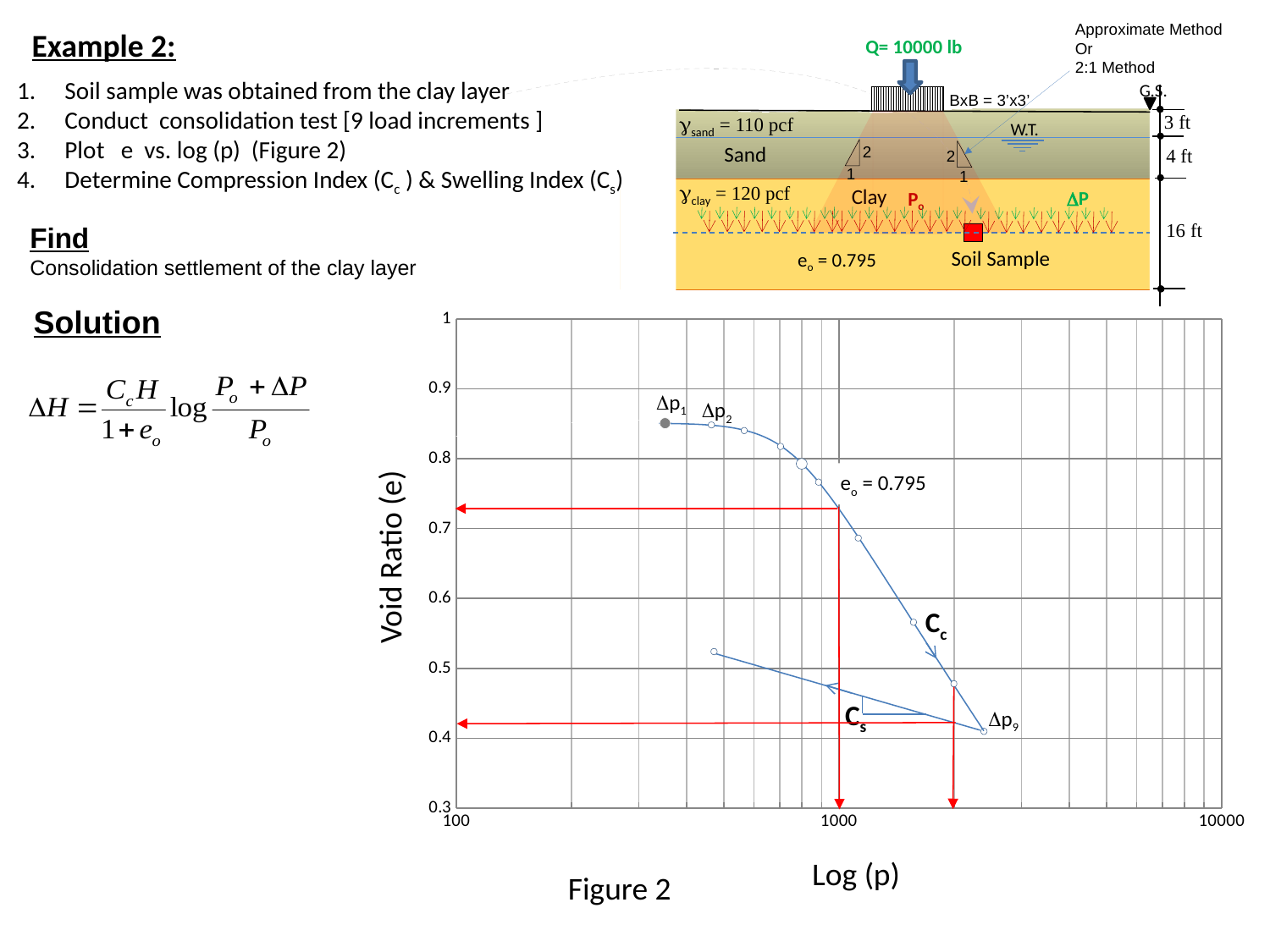
What is the label of the x-axis in Figure 2? Log (p) In Figure 2, does the void ratio rise or fall as the pressure p increases along the loading curve from Δp1 to Δp9? fall What kind of chart is Figure 2? line chart In Figure 2, what value of e_o is annotated on the chart? 0.795 What is the highest tick value shown on the y-axis of Figure 2? 1 In Figure 2, which point has the higher void ratio, Δp1 or Δp9? Δp1 In Figure 2, is the pressure at point Δp1 greater or less than 1000? less What is the lowest tick value shown on the x-axis of Figure 2? 100 In Figure 2, is the void ratio at point Δp1 greater or less than 0.8? greater What is the label of the y-axis in Figure 2? Void Ratio (e) In Figure 2, is the pressure at point Δp9 greater or less than 1000? greater